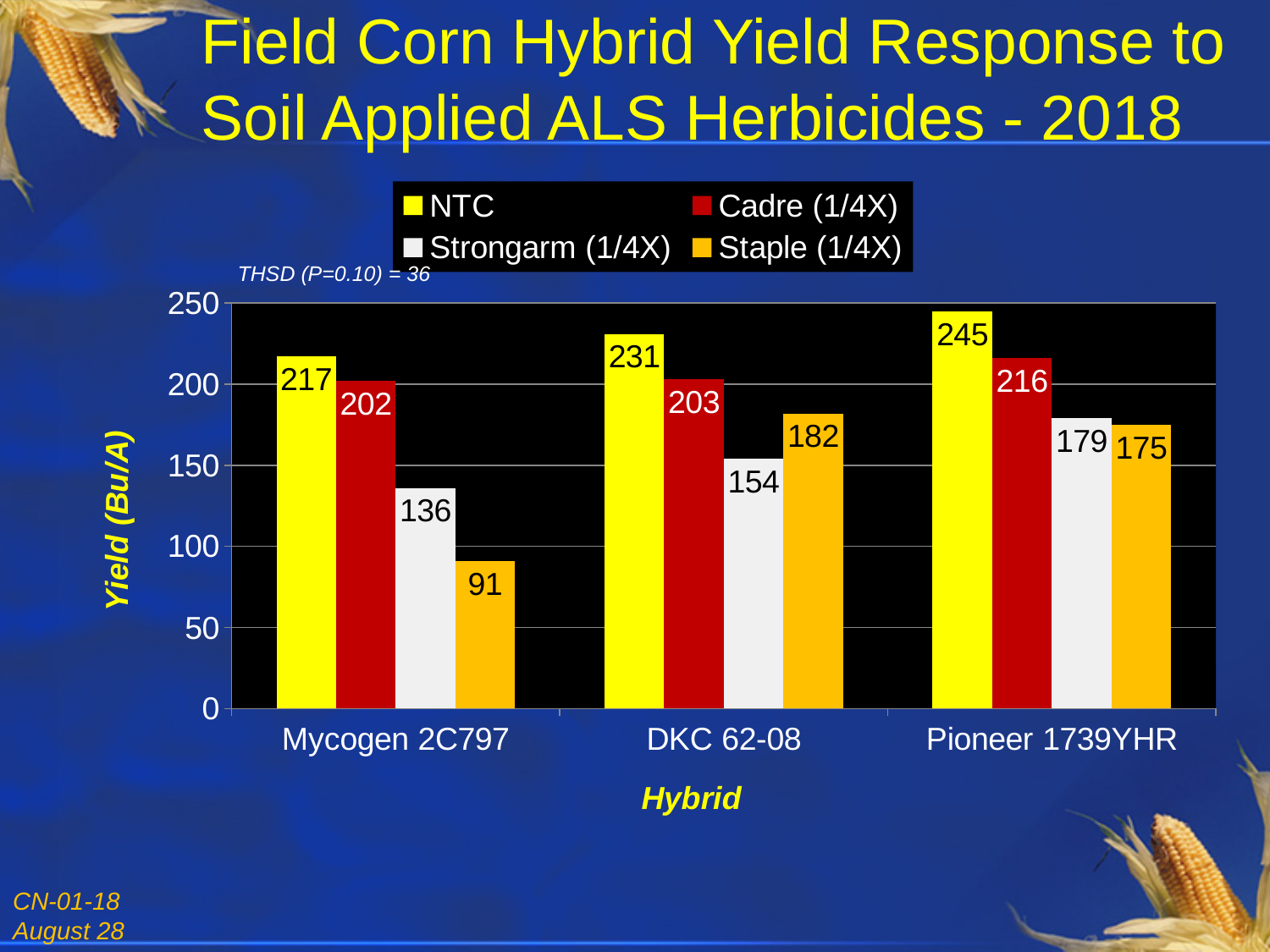
Which hybrid has the lowest Staple (1/4X) yield? Mycogen 2C797 Which is larger for DKC 62-08, the Cadre (1/4X) yield or the Strongarm (1/4X) yield? Cadre (1/4X) What is the label of the y axis? Yield (Bu/A) How many hybrids are shown on the x axis? 3 What is the NTC yield for Mycogen 2C797? 217 What kind of chart is shown on the slide? bar chart What is the Strongarm (1/4X) yield for Pioneer 1739YHR? 179 Is the Strongarm (1/4X) yield for Mycogen 2C797 greater or less than 150? less Which hybrid has the highest NTC yield? Pioneer 1739YHR How many series does the legend list? 4 What is the difference between the NTC and Staple (1/4X) yields for Mycogen 2C797? 126 What is the Staple (1/4X) yield for DKC 62-08? 182